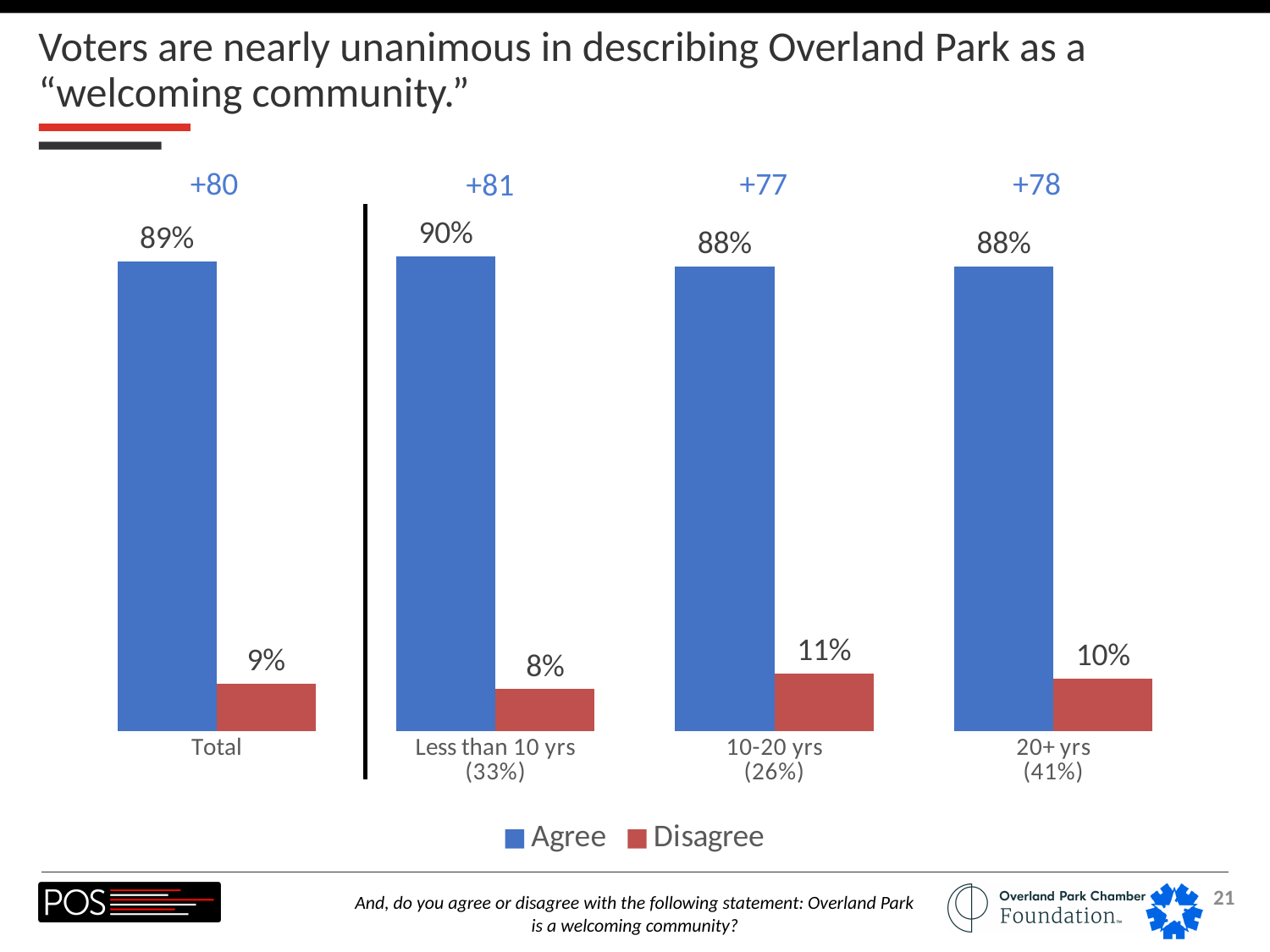
What kind of chart is shown on the slide? Bar chart Which category has the highest Agree value? Less than 10 yrs What is the Disagree value for the 20+ yrs group? 10% Is the Disagree value larger for the 10-20 yrs group or the Less than 10 yrs group? 10-20 yrs How many series does the legend list? 2 What percentage of Total voters agree that Overland Park is a welcoming community? 89% What is the Disagree value for the 10-20 yrs group? 11% How many categories are shown on the x axis? 4 What net figure is shown above the 10-20 yrs bars? +77 What is the Agree value for the Less than 10 yrs group? 90% Which category has the lowest Disagree value? Less than 10 yrs What is the difference between the Agree and Disagree values for the Total group? 80